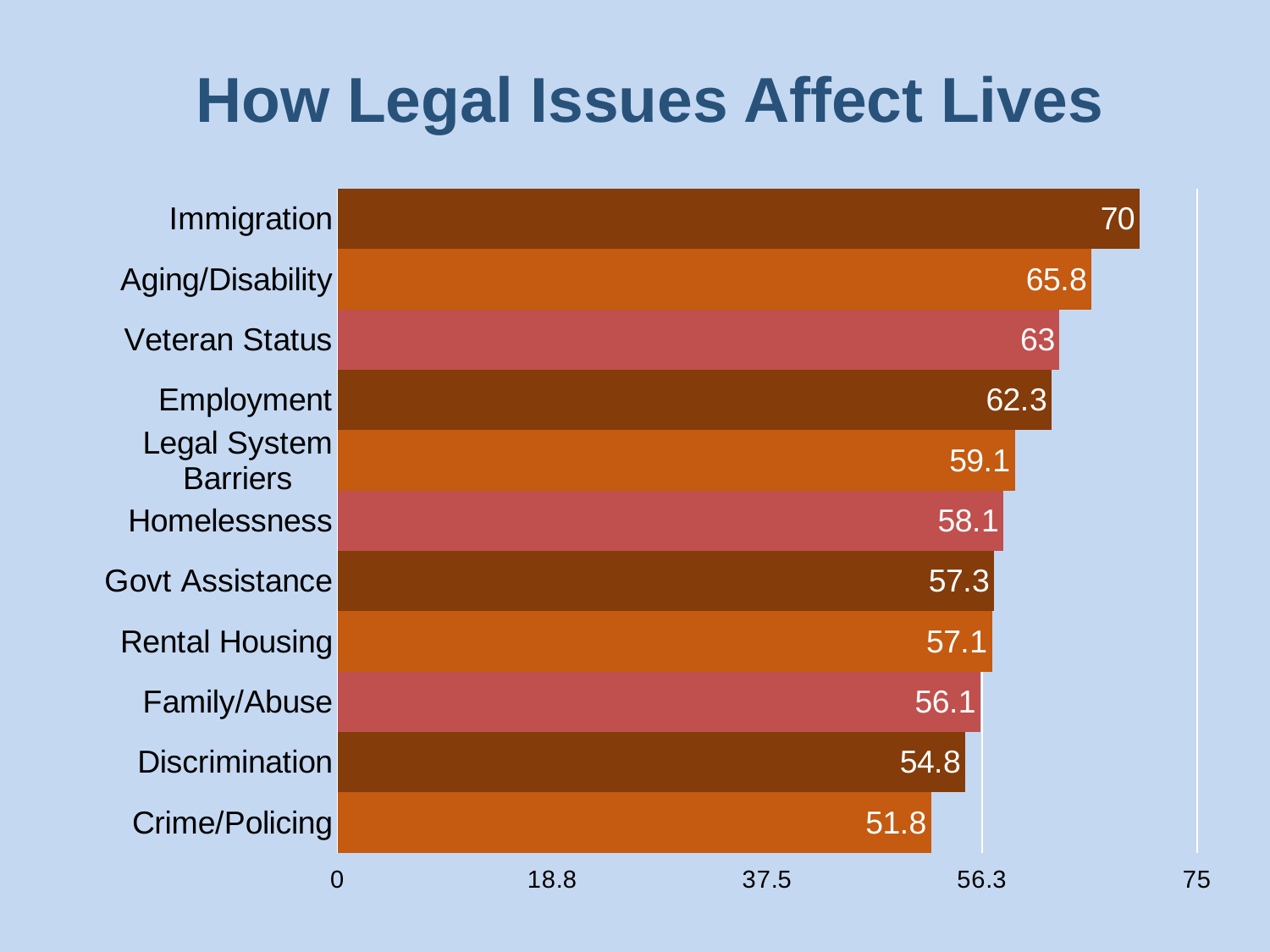
Which category has the lowest value? Crime/Policing Which category has the highest value? Immigration What is the value for Legal System Barriers? 59.1 What is the value for Immigration? 70 Which is larger, the value for Homelessness or the value for Family/Abuse? Homelessness What is the difference between the values for Immigration and Aging/Disability? 4.2 What is the value for Crime/Policing? 51.8 Is the value for Discrimination greater or less than 56.3? less What is the title of the chart? How Legal Issues Affect Lives How many categories are shown in the chart? 11 What is the difference between the values for Veteran Status and Discrimination? 8.2 What kind of chart is shown on the slide? bar chart